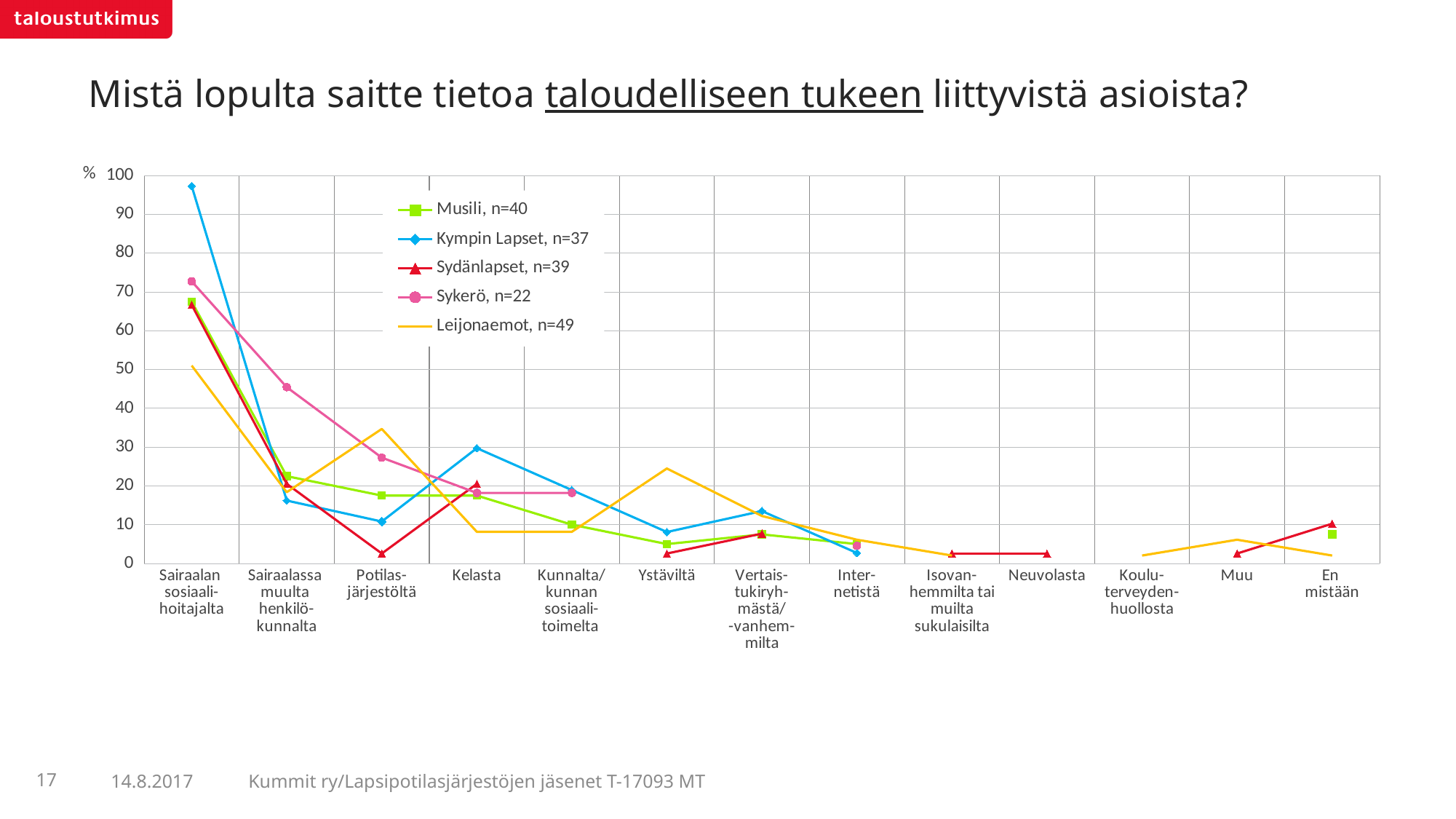
Is the value for Kympin Lapset at 'Sairaalan sosiaalihoitajalta' greater or less than 90? greater Does the Kympin Lapset line rise or fall from 'Sairaalan sosiaalihoitajalta' to 'Sairaalassa muulta henkilökunnalta'? fall Which series has the highest value for 'Kelasta'? Kympin Lapset, n=37 Is the value for Kympin Lapset at 'Kelasta' greater or less than 20? greater How many categories are shown along the x axis? 13 Is the value for Leijonaemot at 'Sairaalan sosiaalihoitajalta' greater or less than 60? less What kind of chart is shown on the slide? line chart How many series does the legend list? 5 Which series has the lowest value for 'Potilasjärjestöltä'? Sydänlapset, n=39 Which series has the lowest value for 'Sairaalan sosiaalihoitajalta'? Leijonaemot, n=49 Which series has the highest value for 'Sairaalan sosiaalihoitajalta'? Kympin Lapset, n=37 At 'Potilasjärjestöltä', which is larger: the value for Leijonaemot or the value for Sykerö? Leijonaemot